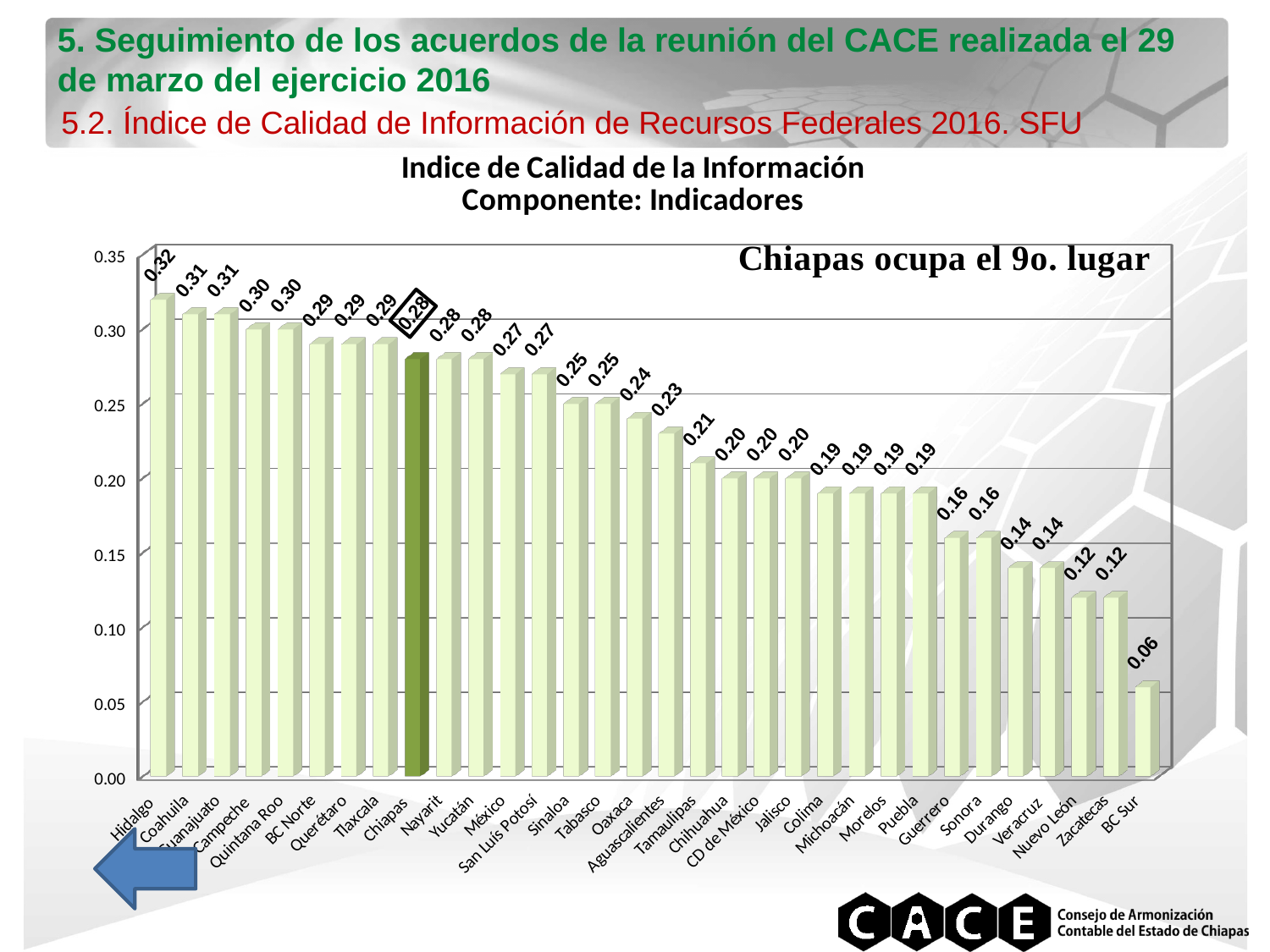
What kind of chart is shown? bar chart Which has a larger value, Sinaloa or Guerrero? Sinaloa What is the difference between the values for Hidalgo and BC Sur? 0.26 How many states are shown on the x axis? 32 Which state has the highest value? Hidalgo Which state has the lowest value? BC Sur What is the value for BC Sur? 0.06 What is the value for Chiapas? 0.28 What is the value for Oaxaca? 0.24 Do the values rise or fall from left to right along the x axis? fall Is the value for Puebla greater or less than 0.20? less What is the difference between the values for Chiapas and Tamaulipas? 0.07